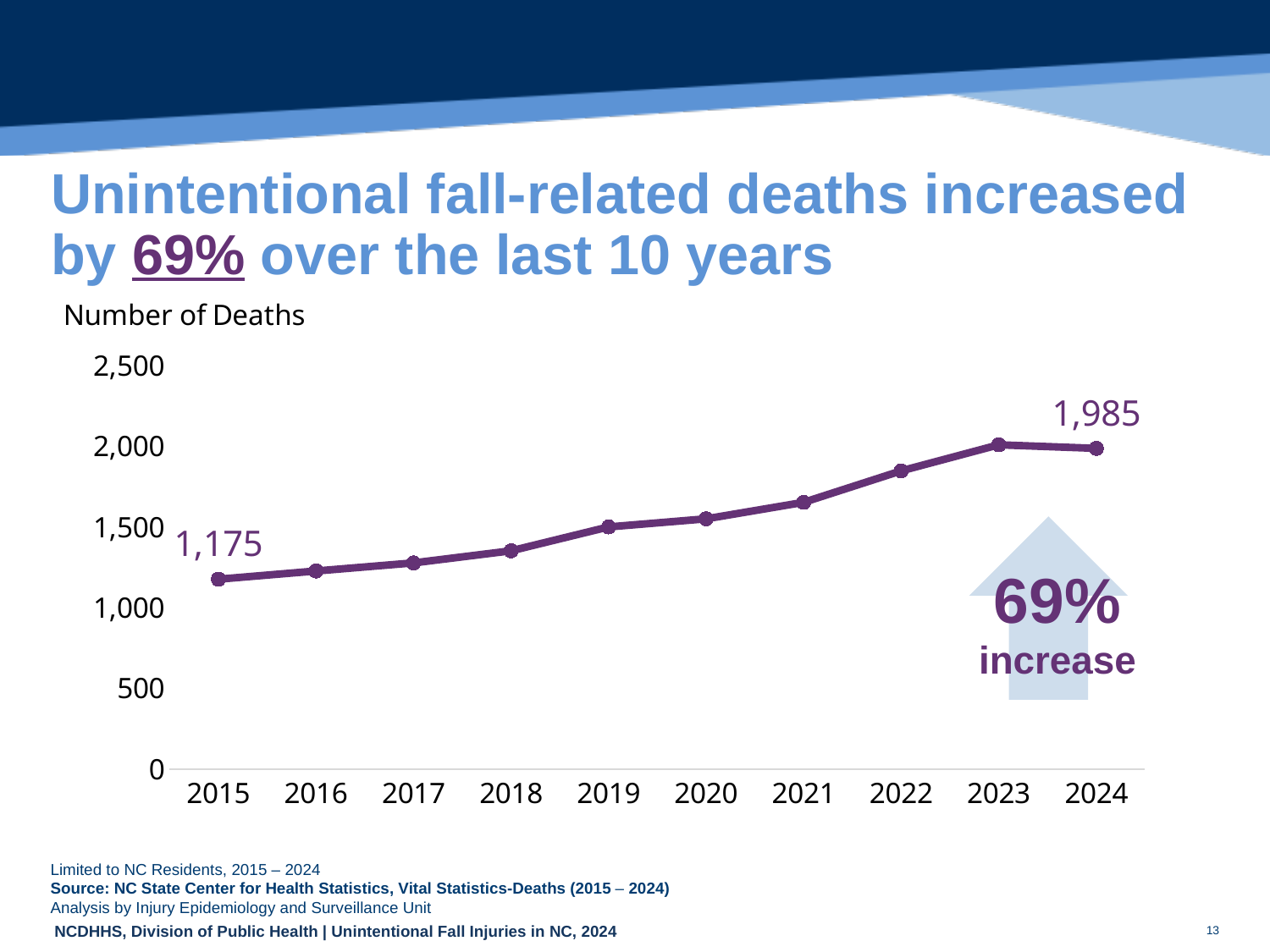
Is the value for 2022 greater or less than 2,000? less Is the value for 2018 greater or less than 1,500? less What is the number of deaths in 2024? 1,985 What is the difference between the number of deaths in 2024 and in 2015? 810 Is the value for 2022 greater or less than 1,500? greater Which year has the lowest number of deaths? 2015 What percentage increase is highlighted in the arrow on the chart? 69% Do the values generally rise or fall from 2015 to 2024? rise What kind of chart is shown on the slide? line chart How many years are plotted on the chart? 10 What is the number of deaths in 2015? 1,175 Which is larger, the number of deaths in 2015 or in 2024? 2024